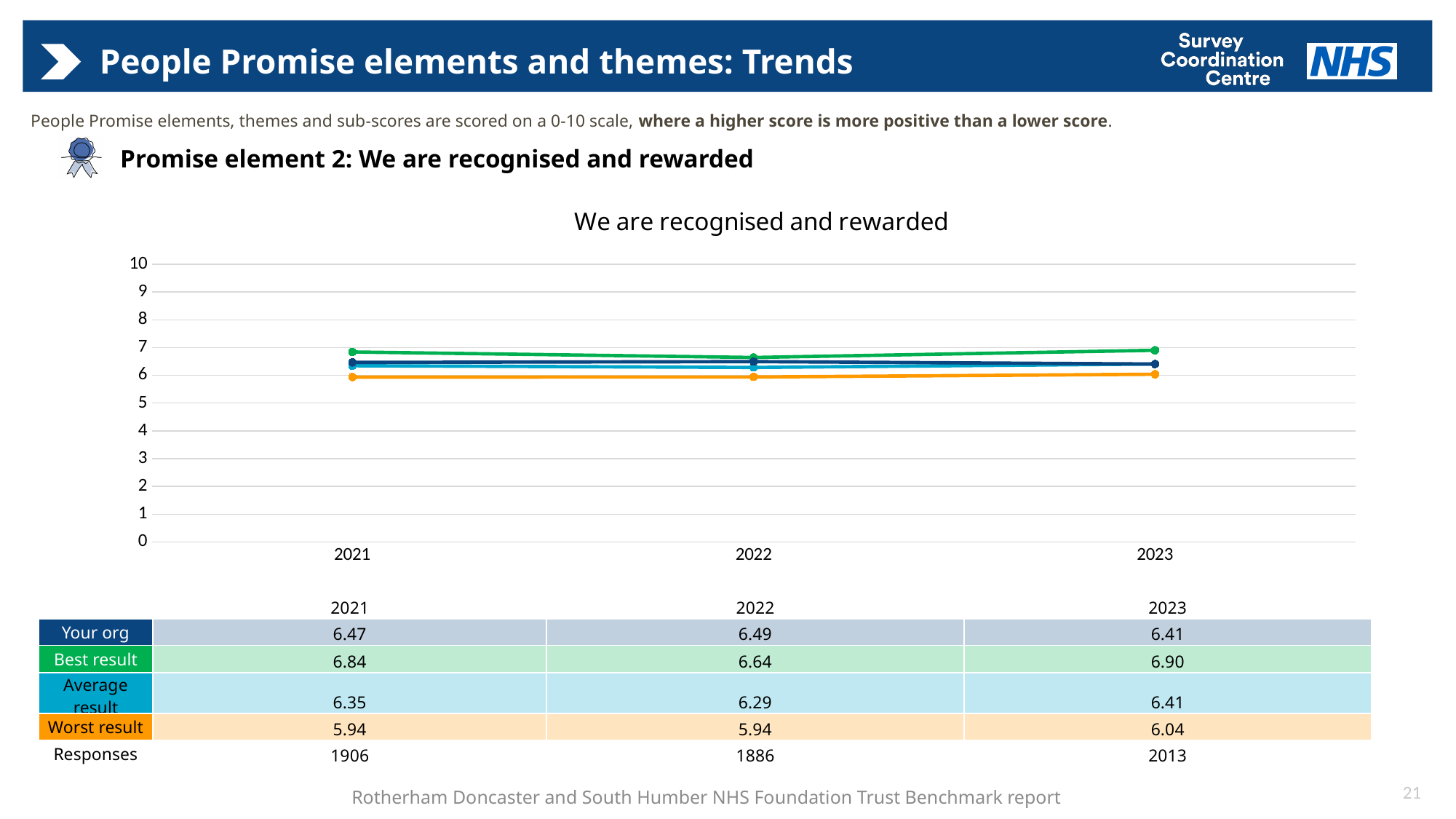
What is the Your org score for 2022? 6.49 What is the Average result score for 2022? 6.29 How many series are shown in the chart? 4 What is the difference between the Best result and Your org scores in 2021? 0.37 What type of chart is shown on the slide? line chart What is the Worst result score for 2021? 5.94 In which year was the Best result score highest? 2023 How many years are plotted on the x axis of the chart? 3 What is the title of the chart? We are recognised and rewarded Which is larger in 2022: the Your org score or the Average result score? Your org In which year was the Your org score lowest? 2023 What is the Best result score for 2023? 6.90